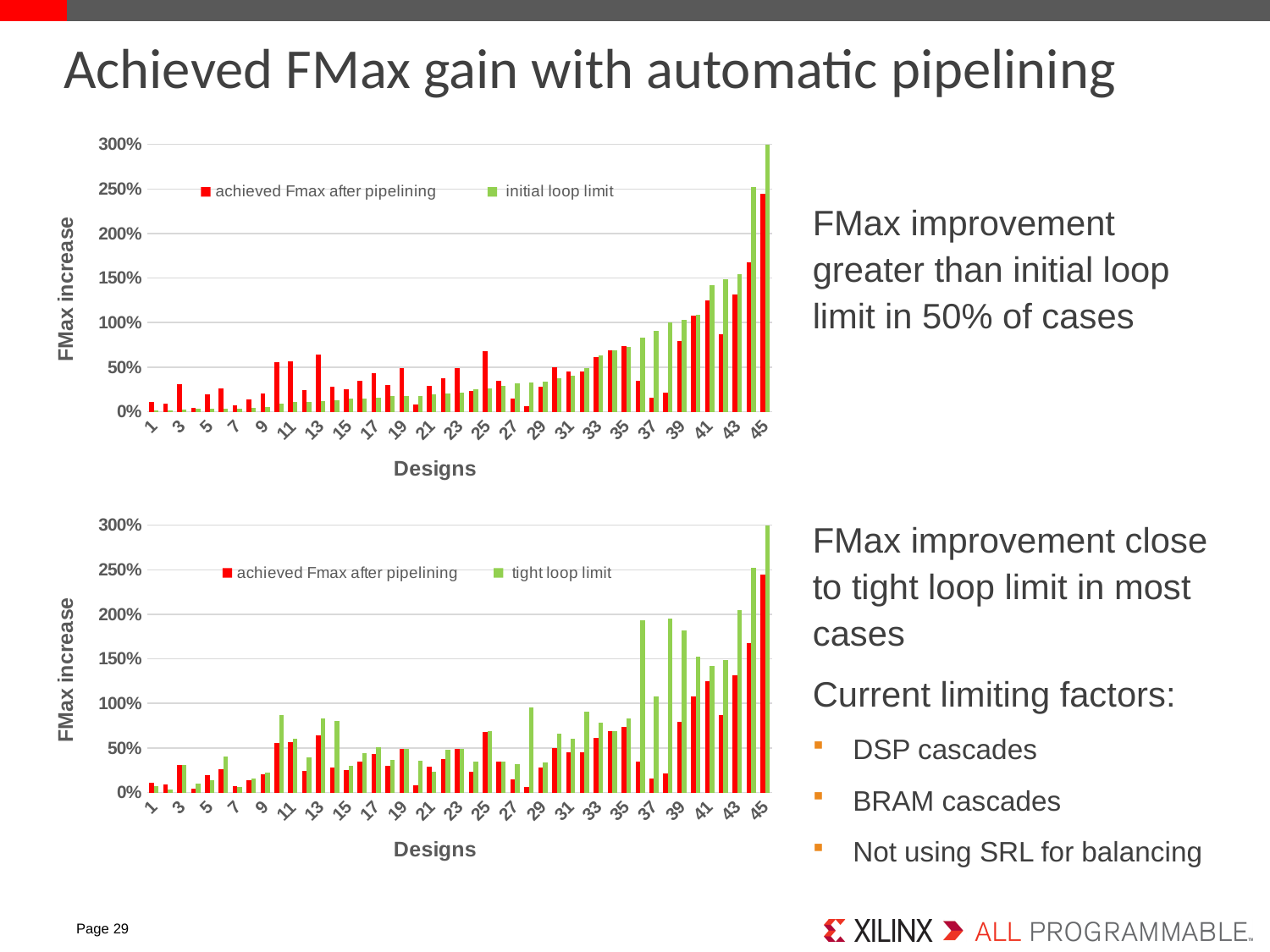
In the top chart, which design has the highest initial loop limit? 45 How many series does the legend of the bottom chart list? 2 In the top chart, is the initial loop limit for design 45 greater or less than 250%? greater In the top chart, what are the two series named in the legend? achieved Fmax after pipelining; initial loop limit How many designs are plotted along the x axis of the top chart? 45 In the bottom chart, what is the name of the green series in the legend? tight loop limit In the bottom chart, is the achieved Fmax after pipelining for design 45 greater or less than 200%? greater In the bottom chart, is the tight loop limit for design 37 greater or less than 150%? less In the top chart, do the initial loop limit values generally rise or fall from design 1 to design 45? rise What kind of chart is the top chart on the slide? bar chart In the bottom chart, which is larger: the achieved Fmax after pipelining for design 45 or for design 1? design 45